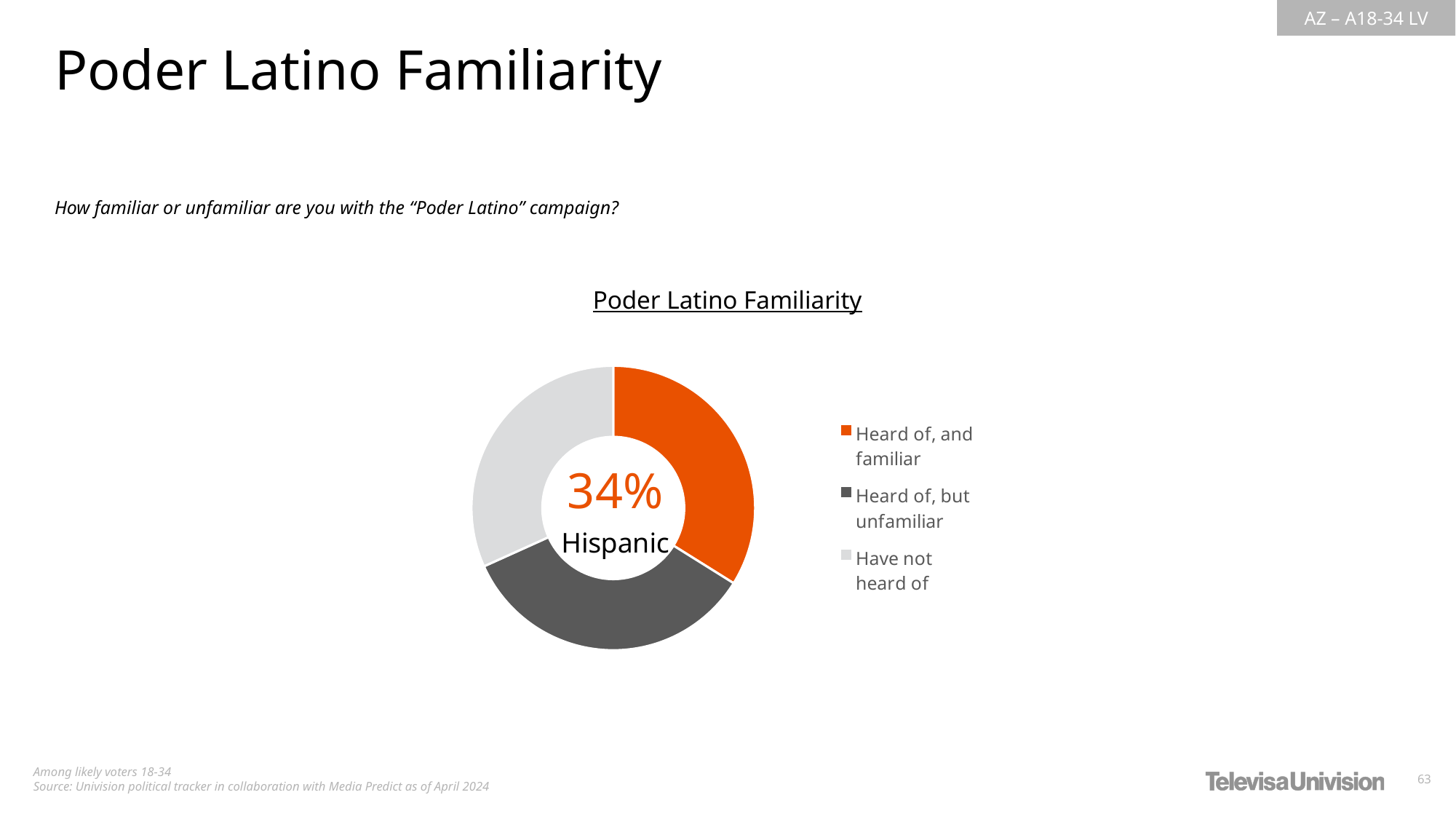
Is the share for 'Have not heard of' greater or less than 50%? less How many categories does the legend of the chart list? 3 Is the share for 'Heard of, but unfamiliar' greater or less than 50%? less Is the share for 'Heard of, and familiar' greater or less than 50%? less What is the title of the chart? Poder Latino Familiarity What share of respondents have heard of, and are familiar with, the Poder Latino campaign? 34% What kind of chart is shown on the slide? Pie (donut) chart What group label is printed below the percentage in the centre of the donut? Hispanic How many slices does the donut chart have? 3 What percentage is printed in the centre of the donut chart? 34%